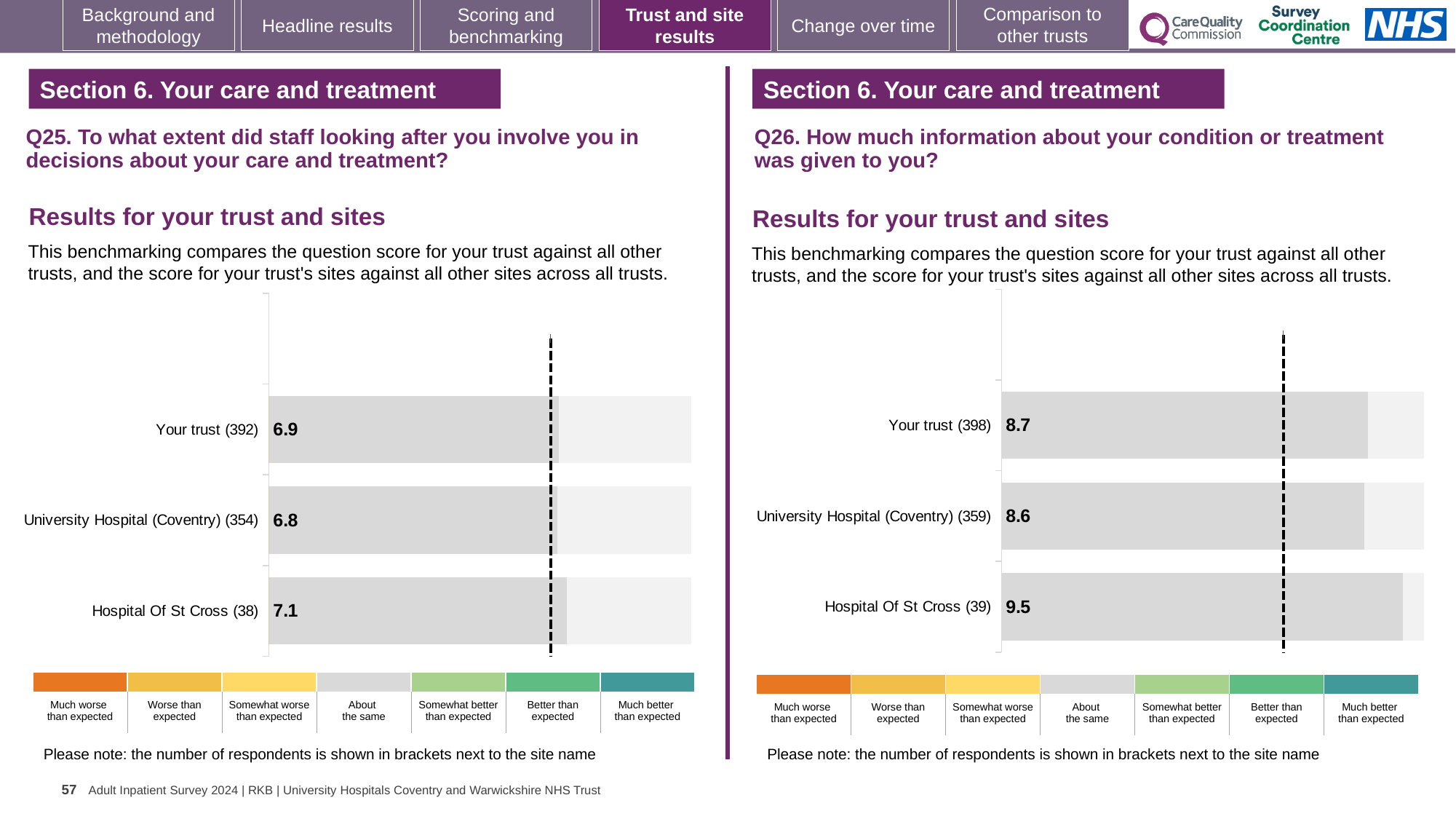
In the Q25 chart on the left, which site or trust has the highest score? Hospital Of St Cross In the Q26 chart on the right, what is the score for University Hospital (Coventry)? 8.6 In the Q26 chart on the right, what is the difference between the scores for Hospital Of St Cross and Your trust? 0.8 In the Q25 chart on the left, how many respondents are shown in brackets for Hospital Of St Cross? 38 What kind of chart is used in the Q26 chart on the right? Bar chart In the Q26 chart on the right, what is the score for Hospital Of St Cross? 9.5 In the Q25 chart on the left, what is the score for Hospital Of St Cross? 7.1 In the Q25 chart on the left, what is the score for Your trust? 6.9 In the Q26 chart on the right, which site or trust has the lowest score? University Hospital (Coventry) In the Q25 chart on the left, what is the difference between the scores for Your trust and University Hospital (Coventry)? 0.1 In the Q26 chart on the right, which has the larger score: Hospital Of St Cross or University Hospital (Coventry)? Hospital Of St Cross How many sites or trusts are plotted in the Q25 chart on the left? 3